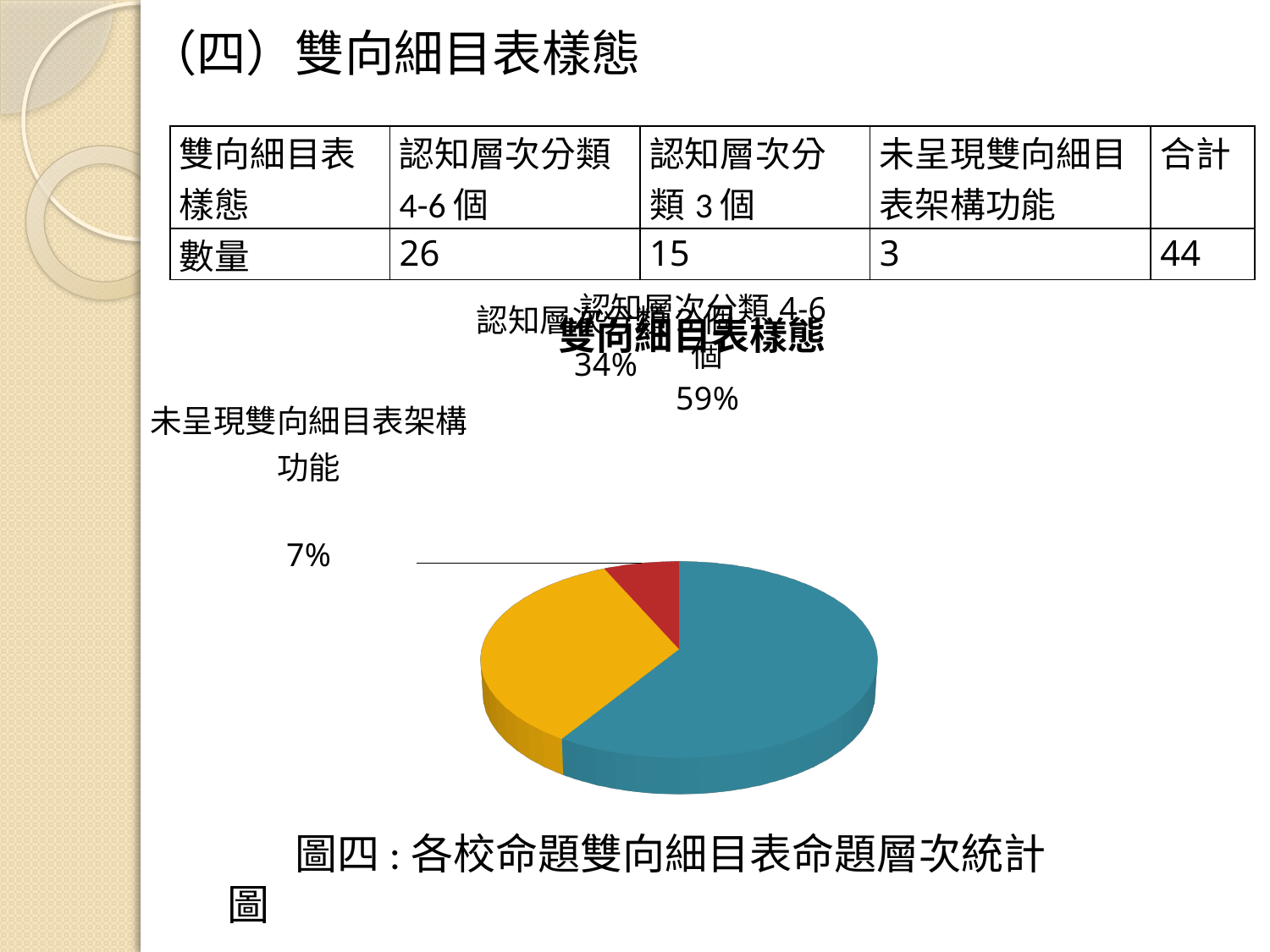
What share of the pie does 認知層次分類 3 個 represent? 34% Which slice is larger, 認知層次分類 3 個 or 未呈現雙向細目表架構功能? 認知層次分類 3 個 Which category has the smallest slice of the pie? 未呈現雙向細目表架構功能 What share of the pie does 認知層次分類 4-6 個 represent? 59% What is the title of the pie chart? 雙向細目表樣態 What share of the pie does 未呈現雙向細目表架構功能 represent? 7% What is the difference in percentage points between the 認知層次分類 3 個 slice and the 未呈現雙向細目表架構功能 slice? 27 What colour is the slice for 認知層次分類 4-6 個? teal blue How many slices does the pie chart have? 3 Which category has the largest slice of the pie? 認知層次分類 4-6 個 What kind of chart is shown on the slide? pie chart What is the difference in percentage points between the 認知層次分類 4-6 個 slice and the 認知層次分類 3 個 slice? 25